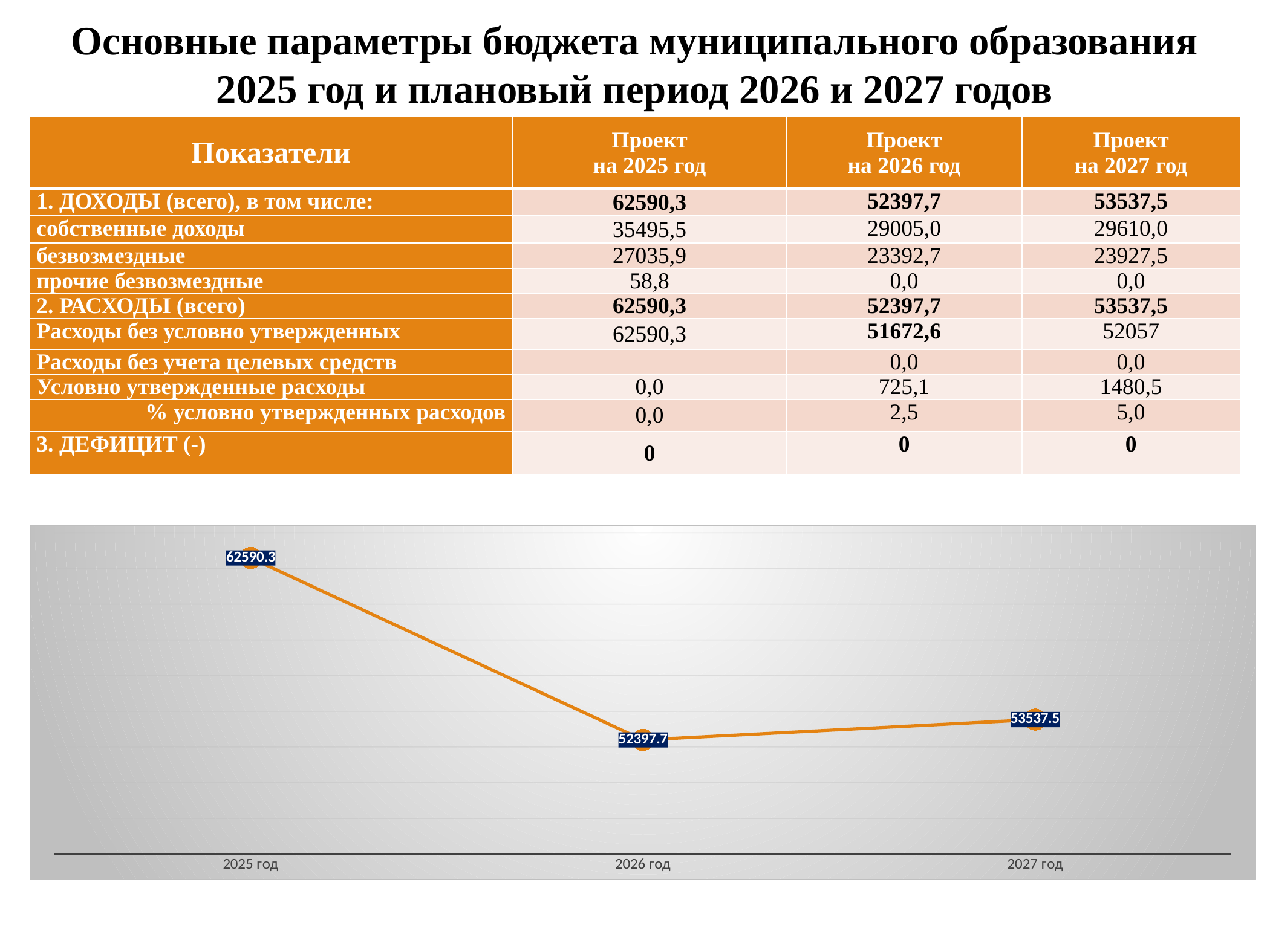
In the line chart, which year has the highest value? 2025 год In the line chart, what is the value for 2027 год? 53537.5 In the line chart, what is the value for 2025 год? 62590.3 What type of chart is shown at the bottom of the slide? line chart How many data points are plotted in the line chart? 3 In the line chart, does the value rise or fall from 2025 год to 2026 год? fall In the line chart, what is the value for 2026 год? 52397.7 In the line chart, which is larger: the value for 2026 год or the value for 2027 год? 2027 год In the line chart, what is the difference between the values for 2025 год and 2026 год? 10192.6 What colour is the line in the chart? orange In the line chart, which year has the lowest value? 2026 год In the line chart, what is the difference between the values for 2027 год and 2026 год? 1139.8